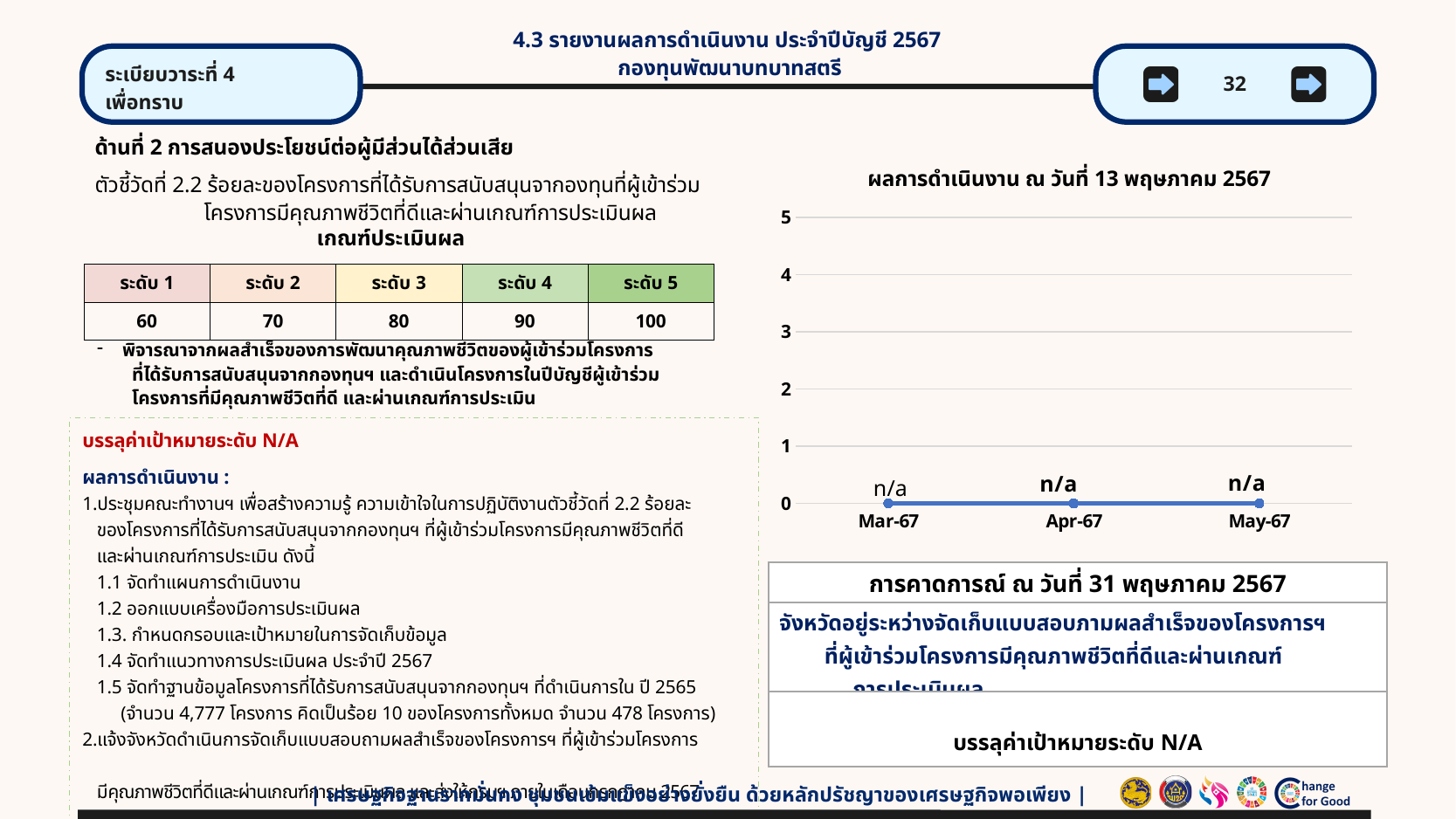
What data label is shown for Mar-67 on the chart? n/a What is the title of the chart? ผลการดำเนินงาน ณ วันที่ 13 พฤษภาคม 2567 Which category appears first on the x axis of the chart? Mar-67 How many data points are plotted on the line chart? 3 Which category appears last on the x axis of the chart? May-67 What kind of chart is shown on the slide? line chart Do the plotted values rise, fall, or stay flat from Mar-67 to May-67? stay flat What data label is shown for Apr-67 on the chart? n/a Is the plotted point for May-67 greater or less than 1 on the y axis? less What data label is shown for May-67 on the chart? n/a What is the highest value shown on the chart's y axis? 5